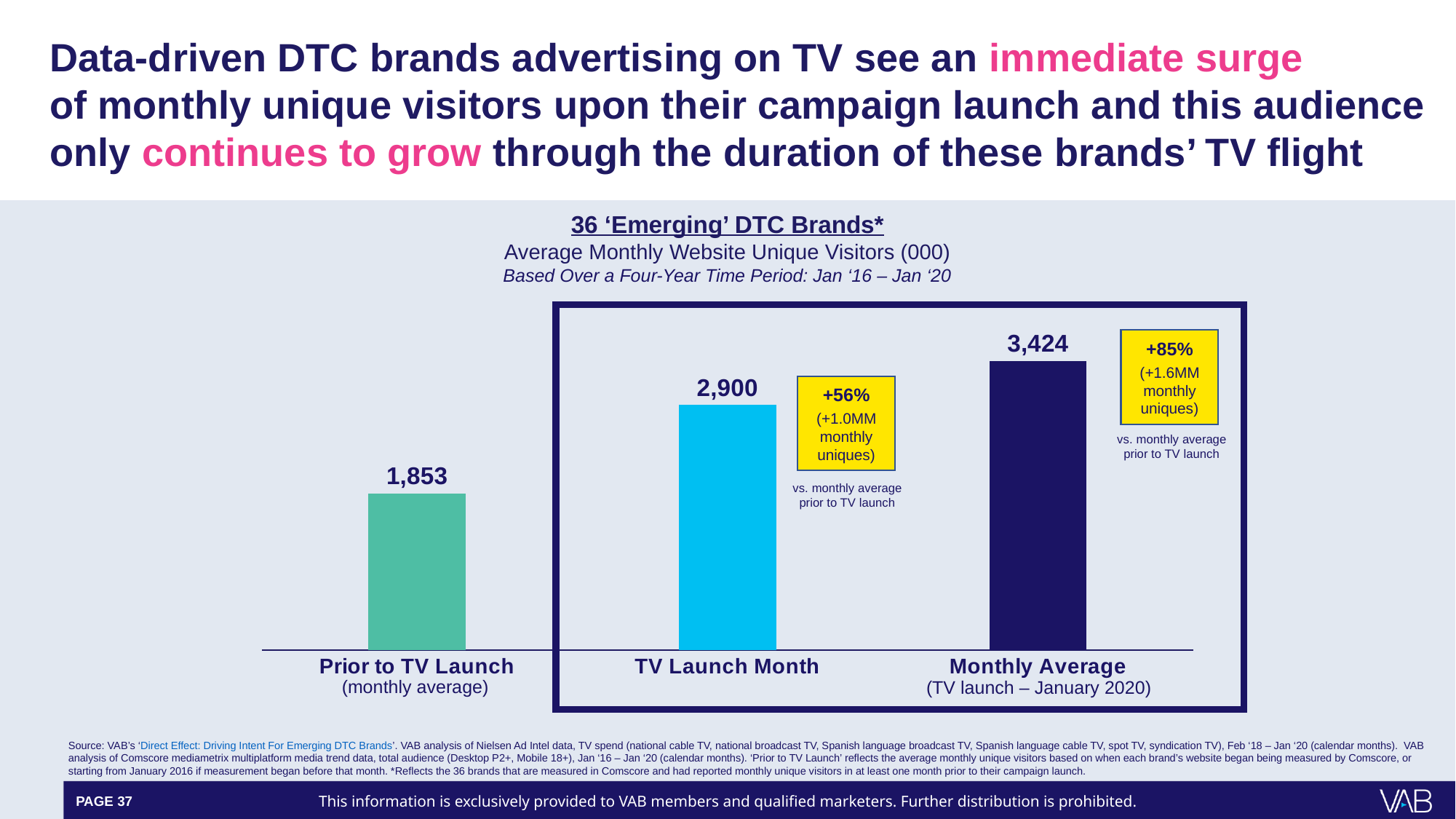
Which category has the lowest value? Prior to TV Launch (monthly average) What is the value for TV Launch Month? 2,900 Do the values rise or fall from left to right across the categories? Rise What percentage increase is shown in the callout next to the Monthly Average (TV launch – January 2020) bar? +85% Which is larger, the value for TV Launch Month or the value for Prior to TV Launch? TV Launch Month Which category has the highest value? Monthly Average (TV launch – January 2020) What is the difference between the TV Launch Month value and the Prior to TV Launch value? 1,047 What is the value for Monthly Average (TV launch – January 2020)? 3,424 What is the difference between the Monthly Average (TV launch – January 2020) value and the Prior to TV Launch value? 1,571 How many bars are shown in the chart? 3 What kind of chart is shown on the slide? Bar chart What is the value for Prior to TV Launch (monthly average)? 1,853